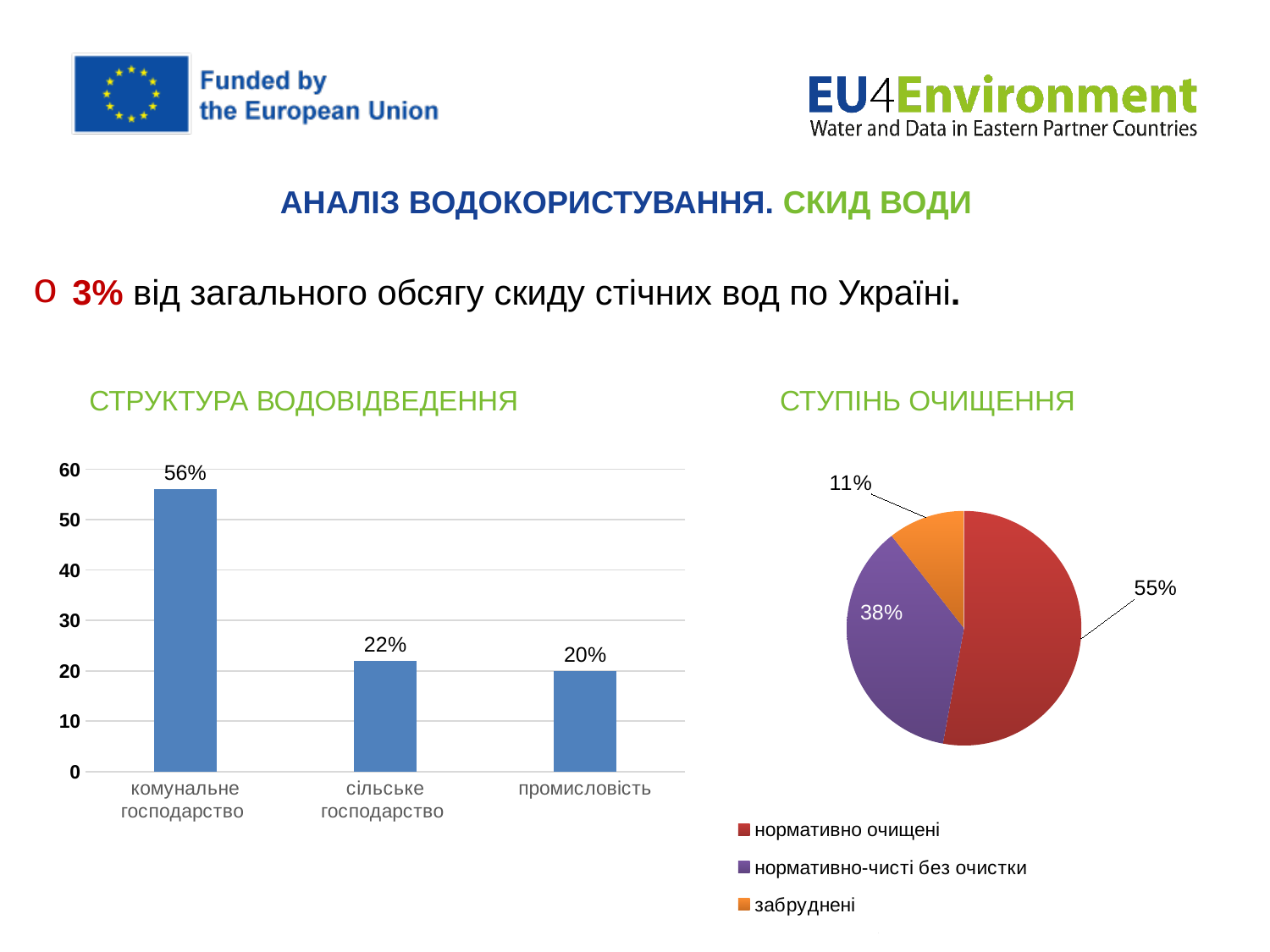
In the 'СТУПІНЬ ОЧИЩЕННЯ' chart, which slice is the largest? нормативно очищені In the 'СТРУКТУРА ВОДОВІДВЕДЕННЯ' chart, what is the difference between комунальне господарство and сільське господарство? 34% In the 'СТРУКТУРА ВОДОВІДВЕДЕННЯ' chart, how many categories are shown? 3 In the 'СТУПІНЬ ОЧИЩЕННЯ' chart, what share is нормативно очищені? 55% In the 'СТРУКТУРА ВОДОВІДВЕДЕННЯ' chart, do the values rise or fall from left to right? fall What type of chart is the 'СТРУКТУРА ВОДОВІДВЕДЕННЯ' chart? bar chart In the 'СТРУКТУРА ВОДОВІДВЕДЕННЯ' chart, what is the value for комунальне господарство? 56% In the 'СТУПІНЬ ОЧИЩЕННЯ' chart, what share is забруднені? 11% In the 'СТРУКТУРА ВОДОВІДВЕДЕННЯ' chart, which category has the lowest value? промисловість How many entries does the legend of the 'СТУПІНЬ ОЧИЩЕННЯ' chart list? 3 In the 'СТРУКТУРА ВОДОВІДВЕДЕННЯ' chart, which category has the highest value? комунальне господарство In the 'СТРУКТУРА ВОДОВІДВЕДЕННЯ' chart, what is the value for промисловість? 20%